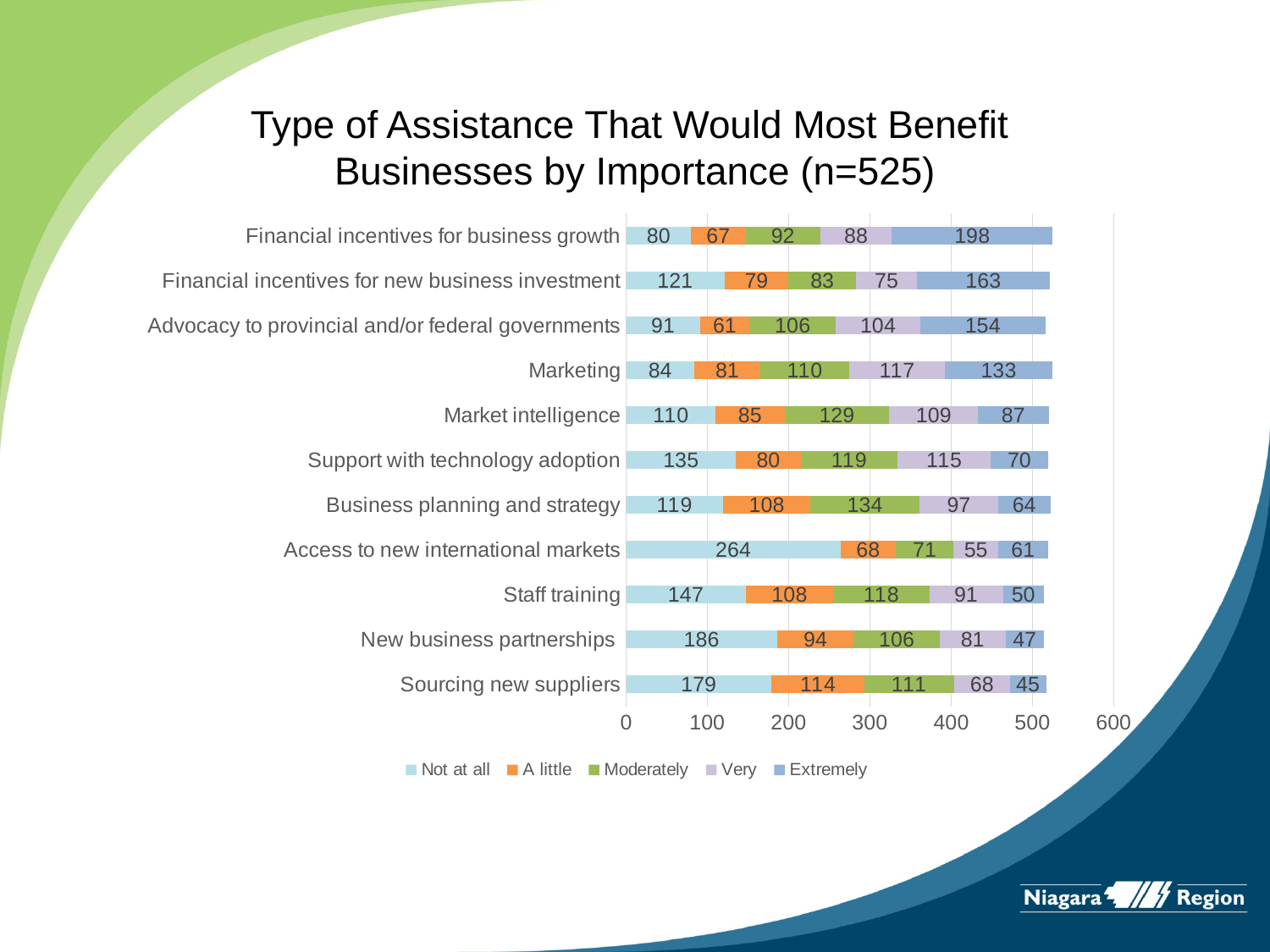
How many types of assistance (categories) are plotted on the chart? 11 What is the difference between the 'Extremely' values for Financial incentives for business growth and Financial incentives for new business investment? 35 What is the total of the stacked bar for Marketing? 525 What type of chart is shown on the slide? Stacked bar chart Which category has the lowest 'Extremely' value? Sourcing new suppliers Which is larger: the 'Not at all' value for New business partnerships or for Sourcing new suppliers? New business partnerships What is the title of the chart? Type of Assistance That Would Most Benefit Businesses by Importance (n=525) What is the 'Extremely' value for Financial incentives for business growth? 198 Which category has the highest 'Extremely' value? Financial incentives for business growth What is the 'Moderately' value for Business planning and strategy? 134 What is the 'Not at all' value for Access to new international markets? 264 How many series does the legend list? 5